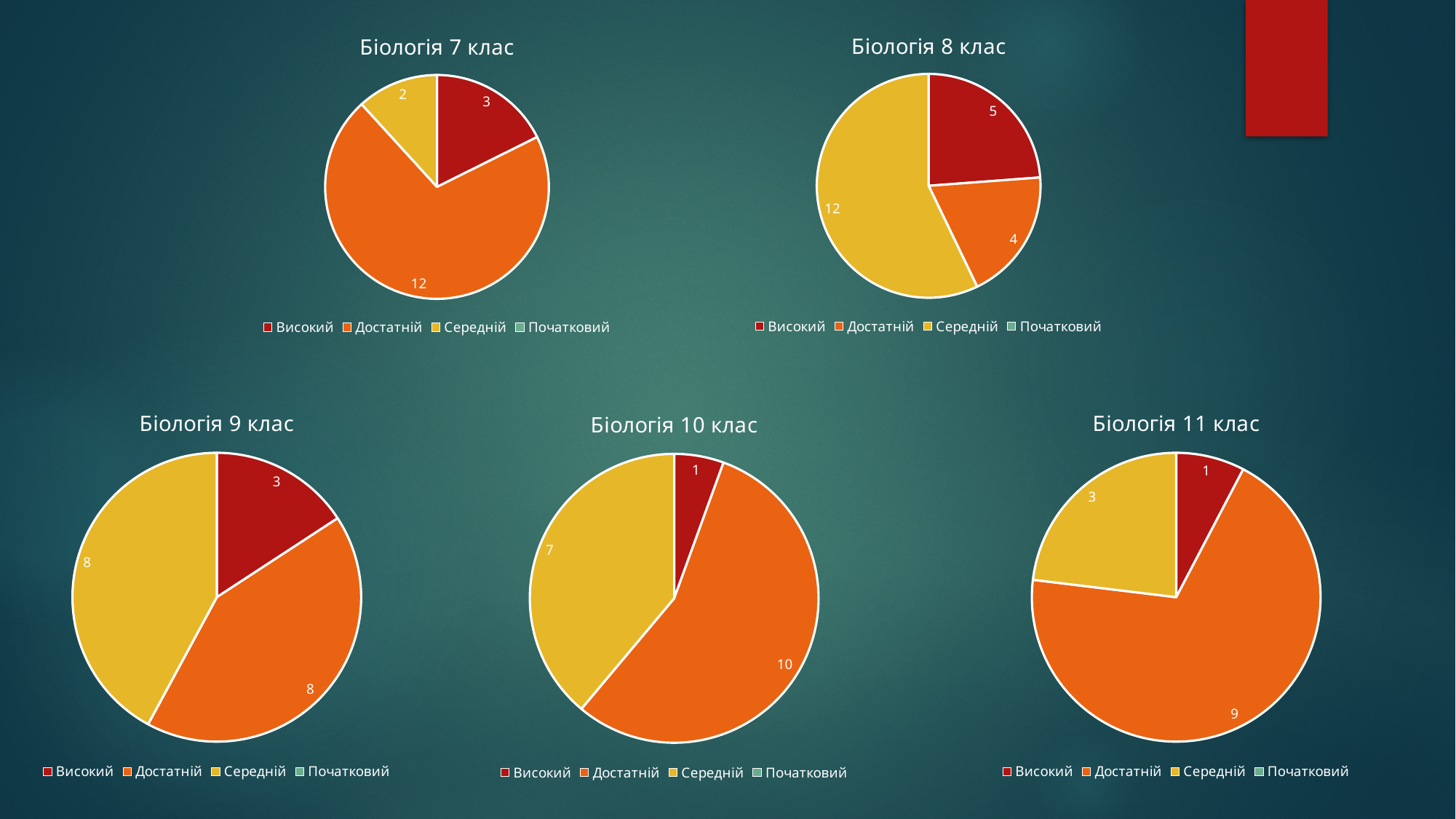
In the chart titled 'Біологія 10 клас', what is the difference between the values for Достатній and Середній? 3 In the chart titled 'Біологія 7 клас', what is the difference between the values for Достатній and Високий? 9 In the chart titled 'Біологія 9 клас', which is larger, the value for Високий or the value for Середній? Середній How many charts are shown on the slide? 5 In the chart titled 'Біологія 10 клас', what is the value for Високий? 1 In the chart titled 'Біологія 11 клас', which category has the largest slice? Достатній What kind of chart is 'Біологія 10 клас'? Pie chart How many entries does the legend list in the chart titled 'Біологія 9 клас'? 4 In the chart titled 'Біологія 8 клас', which category has the smallest labelled slice? Достатній In the chart titled 'Біологія 11 клас', which is larger, the value for Середній or the value for Високий? Середній In the chart titled 'Біологія 7 клас', what is the value for Достатній? 12 In the chart titled 'Біологія 8 клас', what is the value for Середній? 12